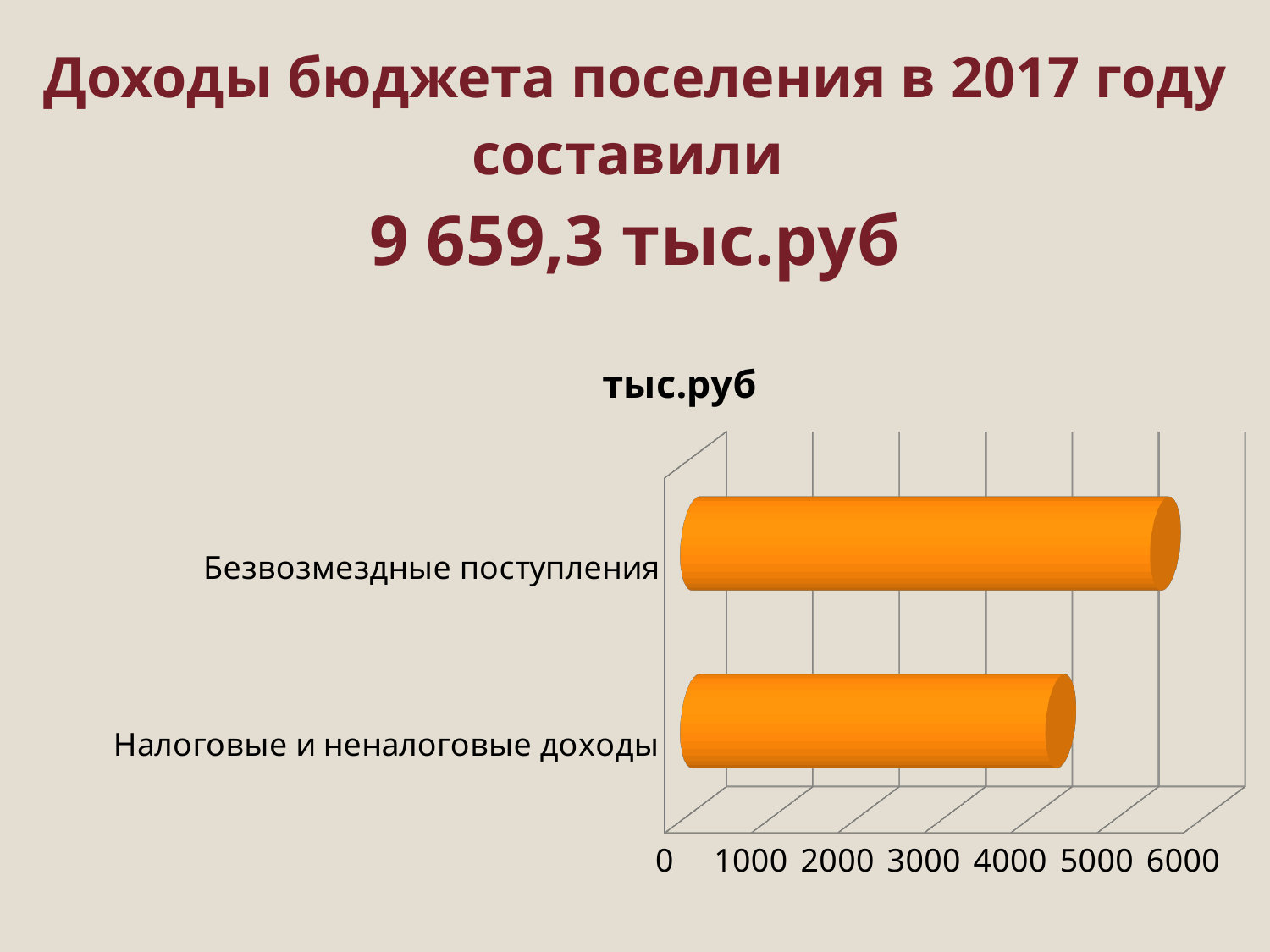
What kind of chart is shown on the slide? bar chart Is the value for Налоговые и неналоговые доходы greater or less than 4000? greater What is the highest value shown on the chart's value axis? 6000 Which category has the highest value in the chart? Безвозмездные поступления How many categories does the chart show? 2 What is the title of the chart? тыс.руб Which is larger: the value for Безвозмездные поступления or the value for Налоговые и неналоговые доходы? Безвозмездные поступления Is the value for Налоговые и неналоговые доходы greater or less than 5000? less Is the value for Безвозмездные поступления greater or less than 5000? greater Which category has the lowest value in the chart? Налоговые и неналоговые доходы